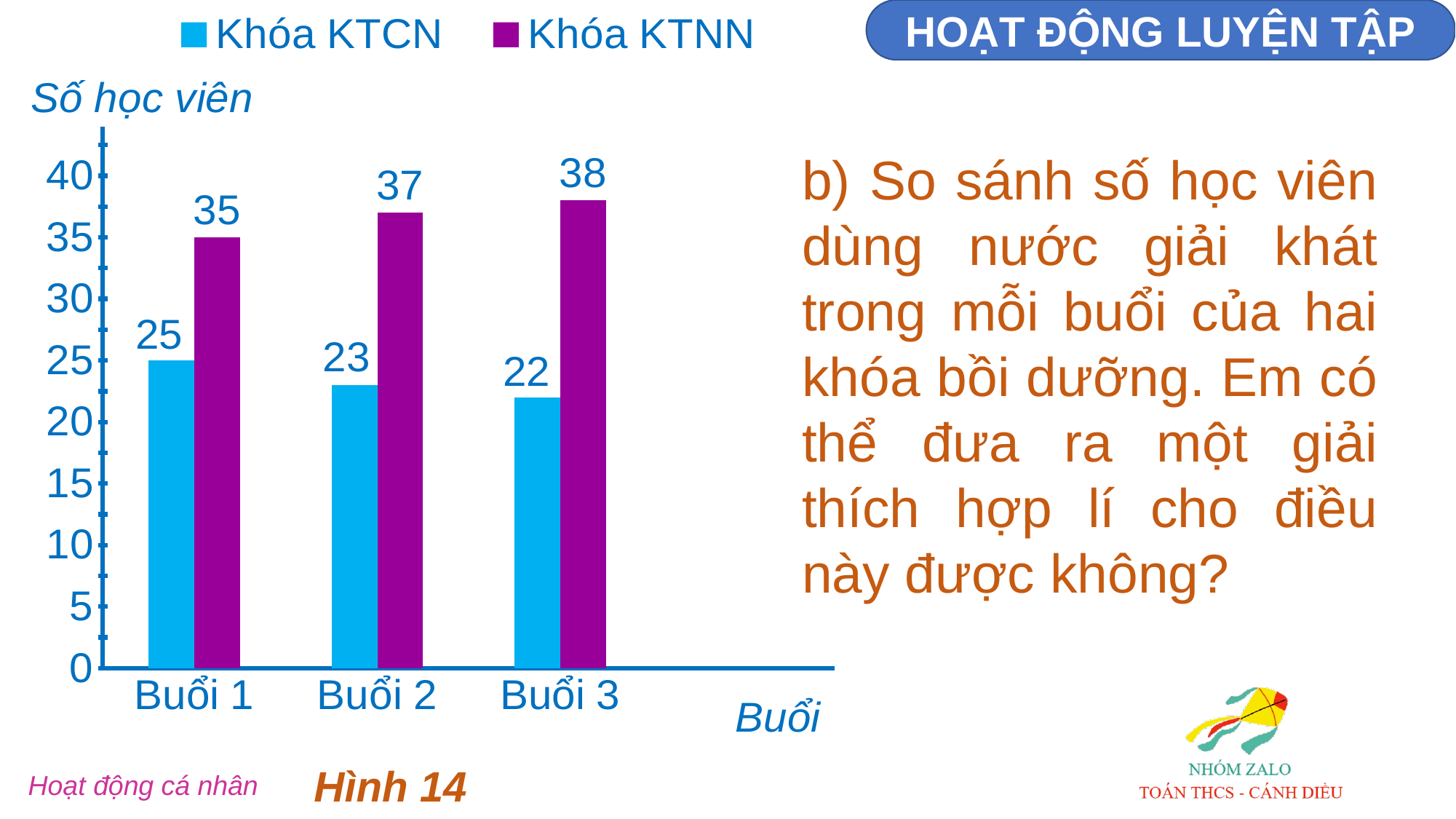
What is the value for Khóa KTNN in Buổi 3? 38 Which is larger in Buổi 2: Khóa KTCN or Khóa KTNN? Khóa KTNN Do the Khóa KTCN values rise or fall from Buổi 1 to Buổi 3? Fall What is the difference between Khóa KTNN and Khóa KTCN in Buổi 3? 16 What is the value for Khóa KTNN in Buổi 2? 37 What kind of chart is shown? Bar chart How many sessions (categories) are shown on the x axis? 3 What is the value for Khóa KTCN in Buổi 1? 25 In which session (Buổi) is the Khóa KTNN value highest? Buổi 3 How many series does the legend list? 2 What is the difference between Khóa KTNN and Khóa KTCN in Buổi 1? 10 In which session (Buổi) is the Khóa KTCN value lowest? Buổi 3